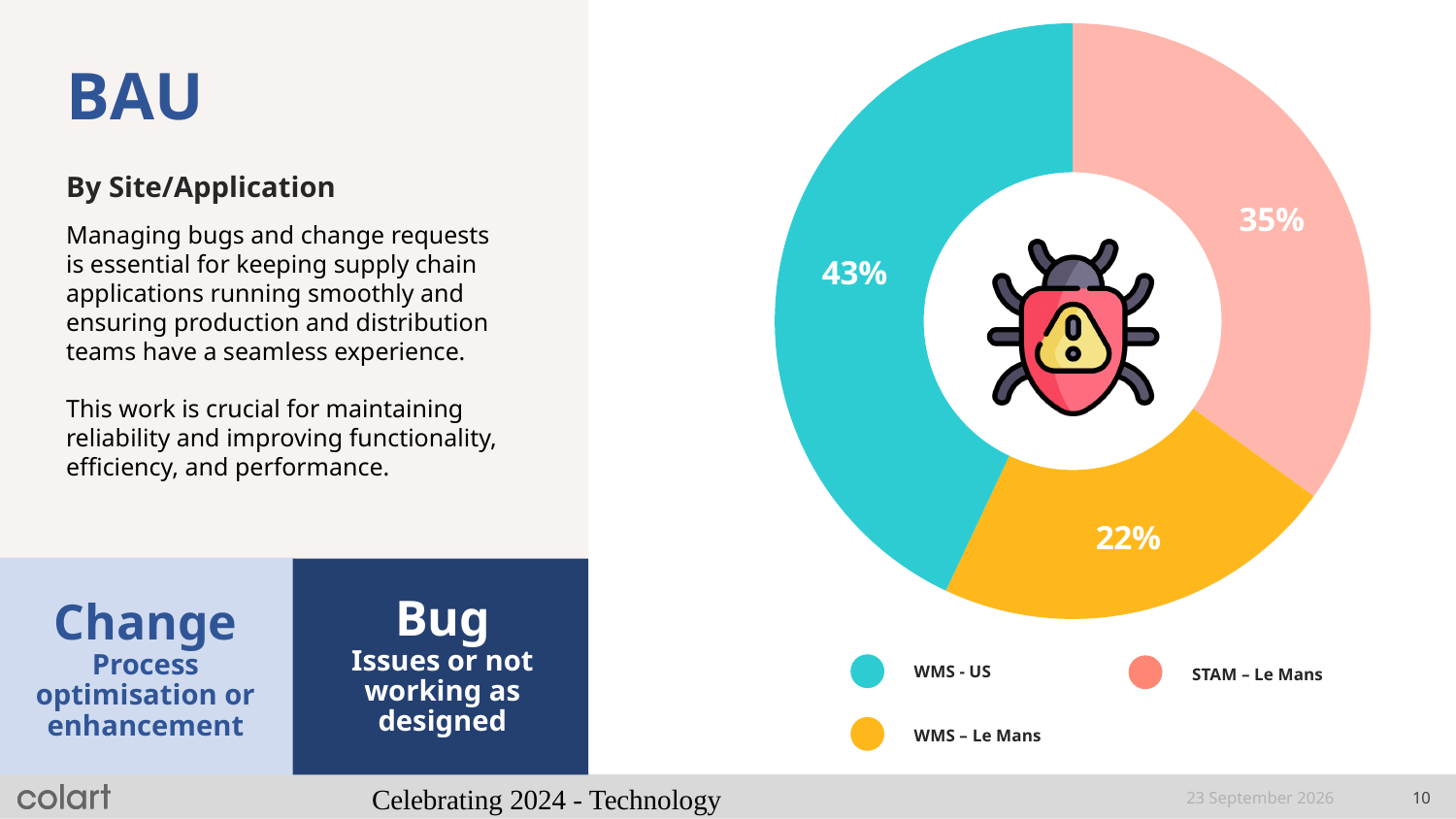
What percentage is shown for WMS – Le Mans? 22% What kind of chart is shown on the slide? Donut (pie) chart What share of the donut chart does WMS - US account for? 43% How many categories are shown in the chart? 3 What is the difference in percentage points between STAM – Le Mans and WMS – Le Mans? 13 What percentage is shown for STAM – Le Mans? 35% What is the difference in percentage points between WMS - US and WMS – Le Mans? 21 Which site/application has the smallest share of the chart? WMS – Le Mans Which has a larger share, STAM – Le Mans or WMS – Le Mans? STAM – Le Mans What colour represents WMS – Le Mans in the chart? Orange What is the combined share of the two Le Mans categories (STAM – Le Mans and WMS – Le Mans)? 57% Which site/application has the largest share of the chart? WMS - US